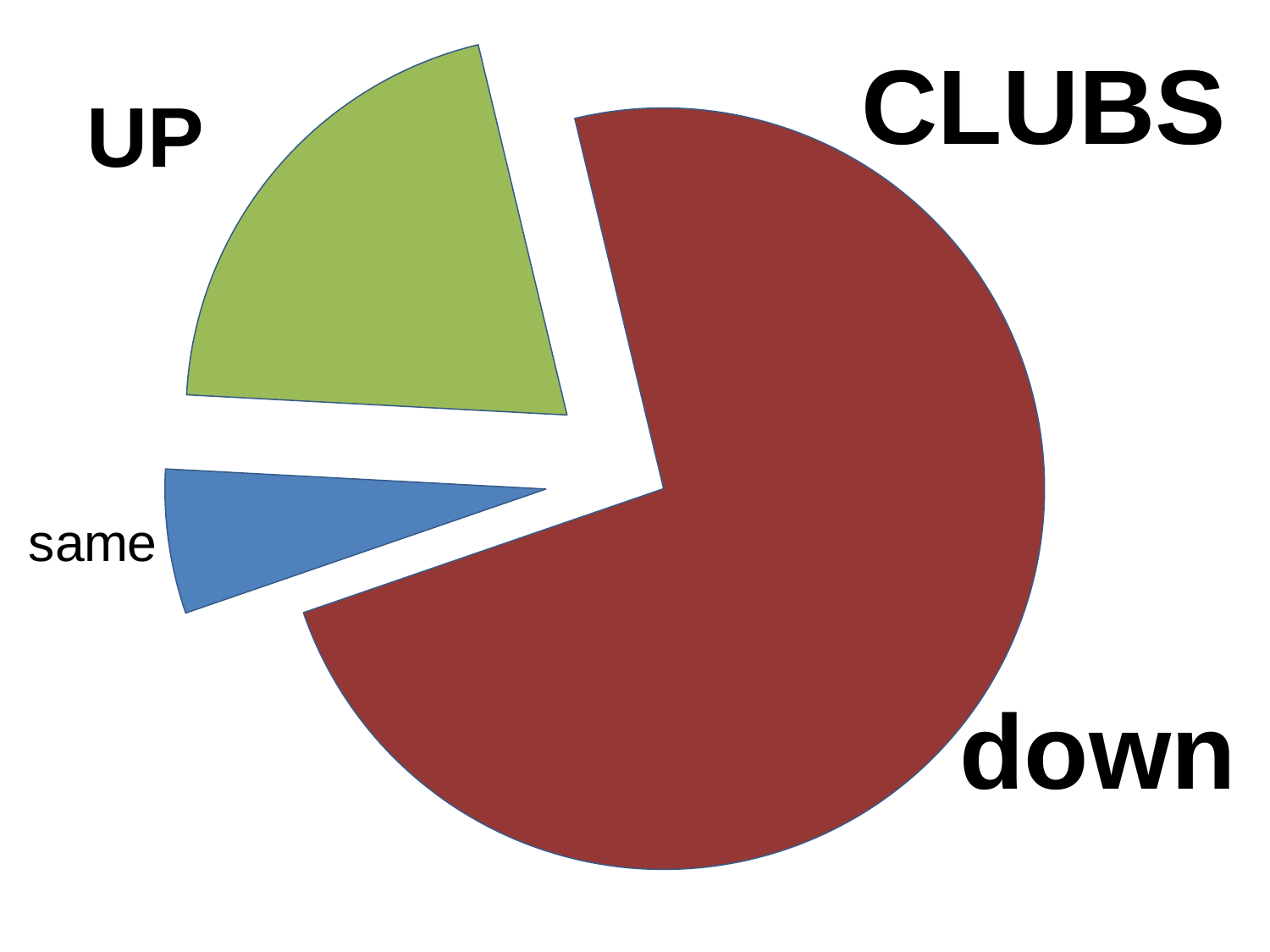
Which slice of the pie chart is the largest? down What is the title of the pie chart? CLUBS Which slice of the pie chart is the smallest? same What kind of chart is shown on the slide? pie chart Which slice is larger, UP or same? UP What colour is the slice labelled 'down'? red Which slice is larger, down or UP? down How many slices does the pie chart have? 3